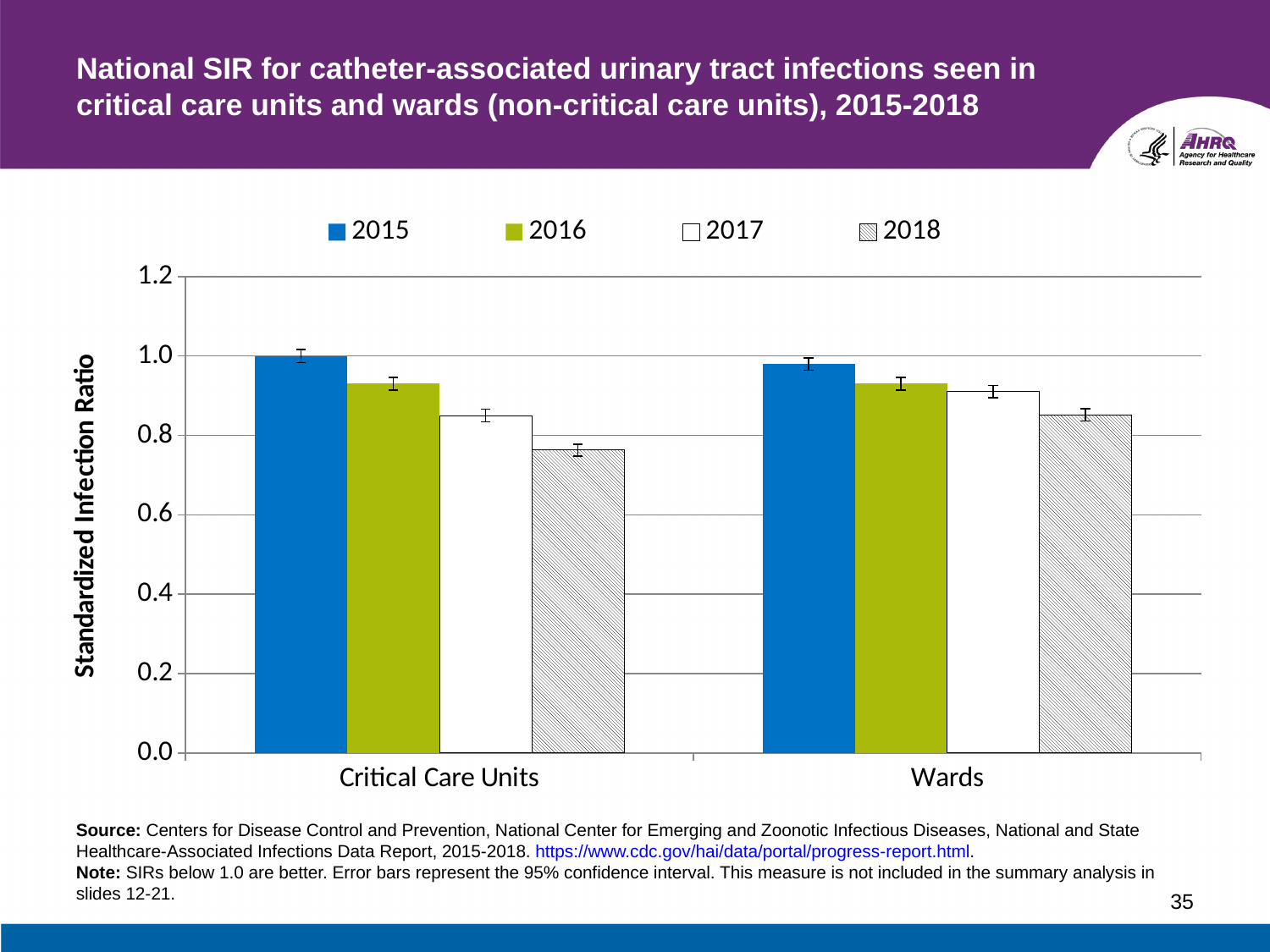
Which years are listed in the legend? 2015, 2016, 2017, 2018 For Critical Care Units, which year has the highest Standardized Infection Ratio? 2015 Is the 2018 value for Critical Care Units greater or less than 0.8? less For Critical Care Units, which year has the lowest Standardized Infection Ratio? 2018 Within each category, do the values rise or fall from 2015 to 2018? Fall Is the 2018 value for Wards greater or less than 0.8? greater For Wards, which year has the lowest Standardized Infection Ratio? 2018 What kind of chart is shown on the slide? Bar chart Which is larger, the 2018 value for Critical Care Units or the 2018 value for Wards? Wards What is the label of the y axis? Standardized Infection Ratio How many series does the legend list? 4 How many categories are shown on the x axis? 2